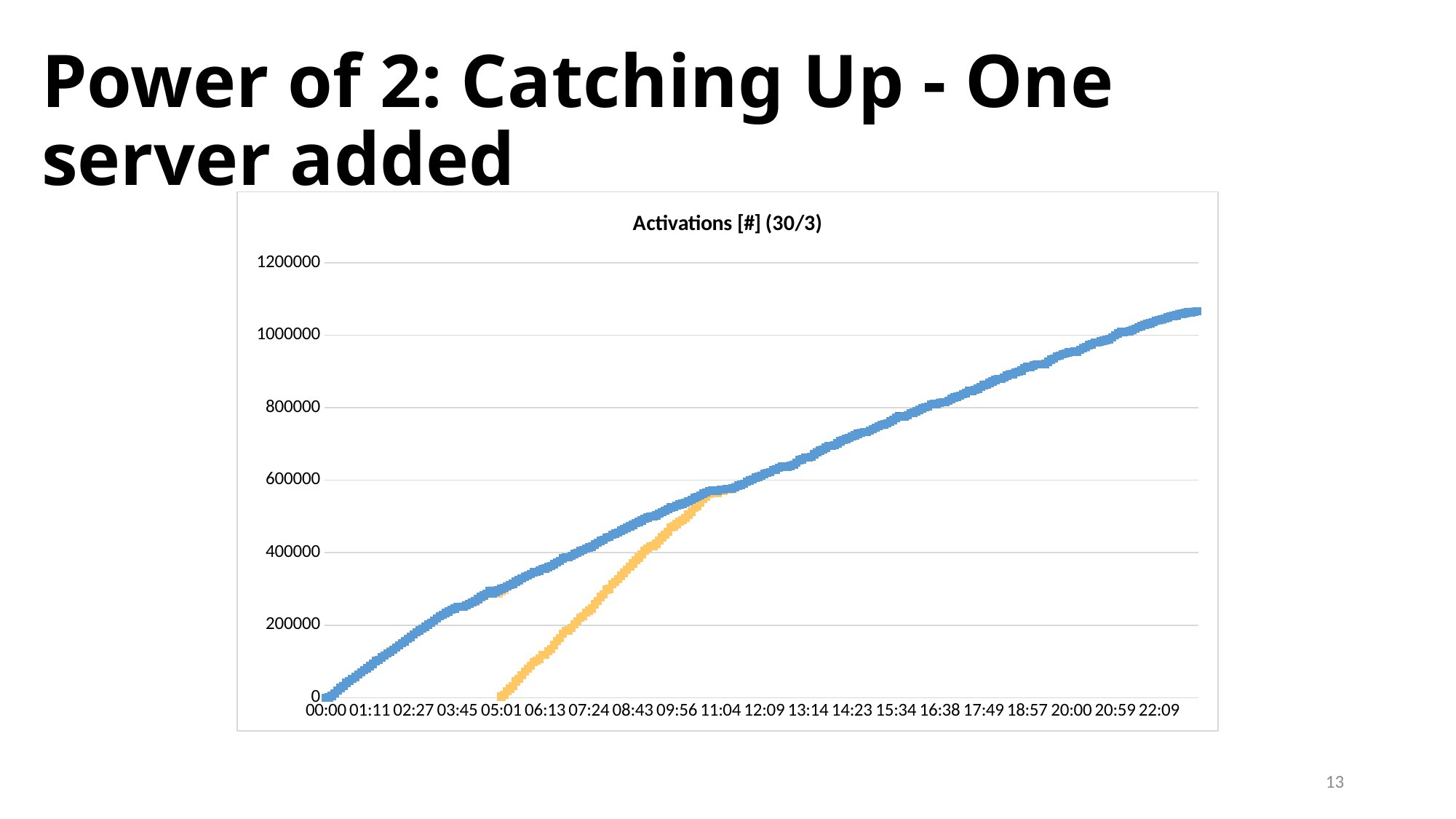
Is the value of the blue line at 18:57 greater or less than 1000000? less How many time labels are shown along the x axis? 20 Is the value of the blue line at 13:14 greater or less than 600000? greater Is the value of the blue line at 05:01 greater or less than 200000? greater At which x-axis time label does the orange line start? 05:01 What kind of chart is shown on the slide? line chart What is the title of the chart? Activations [#] (30/3) Does the blue line rise or fall as time moves from 00:00 to 22:09? rises What is the highest value shown on the y axis? 1200000